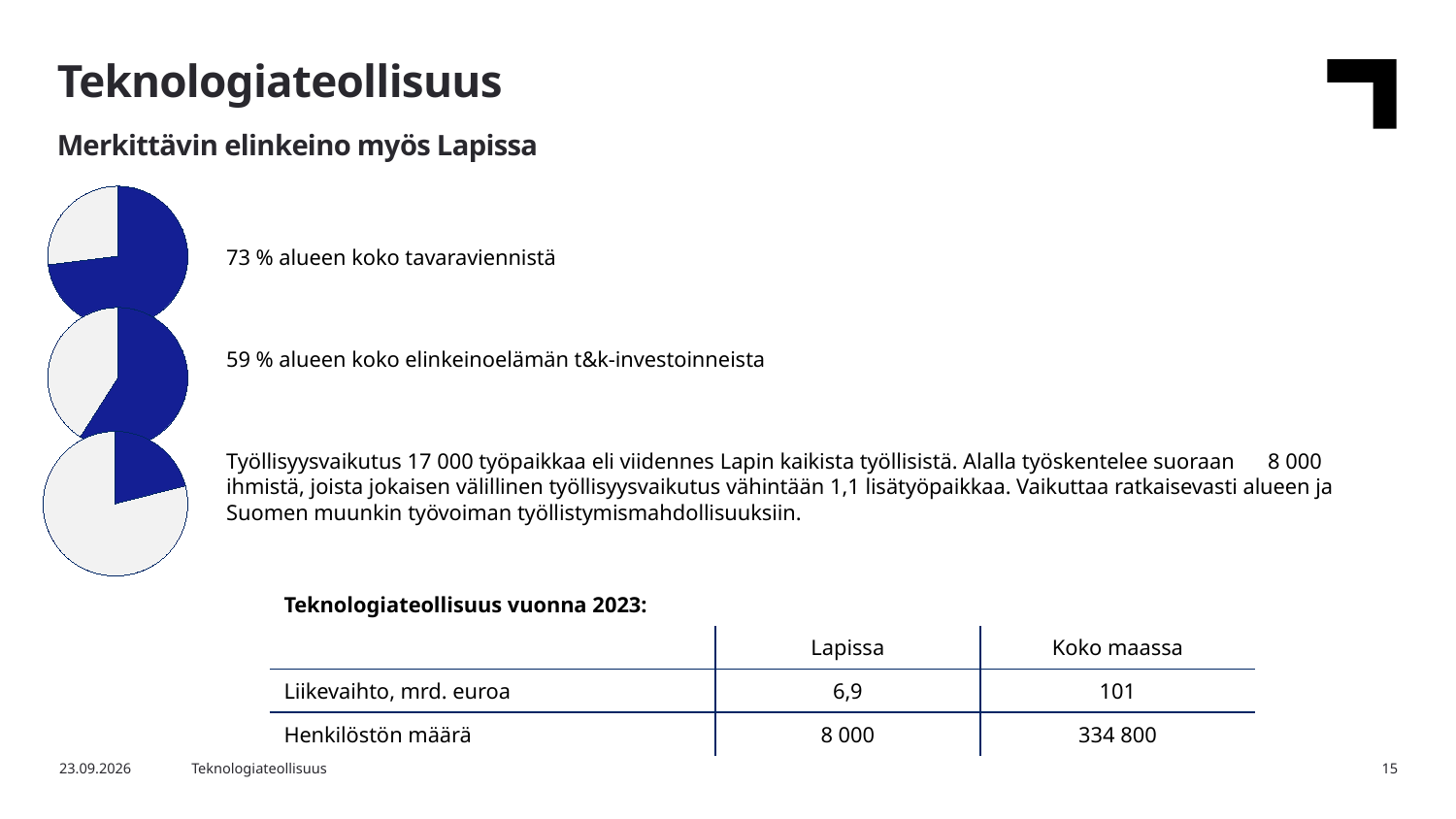
Which pie chart has the smallest blue slice: the top, middle or bottom one? Bottom What colour is used for the highlighted slice in each pie chart? Blue What kind of charts are shown on the left side of the slide? Pie charts What is the title of the slide containing the pie charts? Teknologiateollisuus How many pie charts are on the slide? 3 Is the blue slice in the top pie chart larger or smaller than the blue slice in the middle pie chart? Larger What is the difference in percentage points between the shares shown by the top pie chart (73 %) and the middle pie chart (59 %)? 14 percentage points In the middle pie chart, what share of the region's business R&D investments does the blue slice represent? 59 % Is the blue slice in the top pie chart greater or less than 50% of the pie? greater Is the blue slice in the bottom pie chart greater or less than 50% of the pie? less In the top pie chart, what share of the region's total goods exports does the blue slice represent? 73 % Which pie chart has the largest blue slice: the top, middle or bottom one? Top